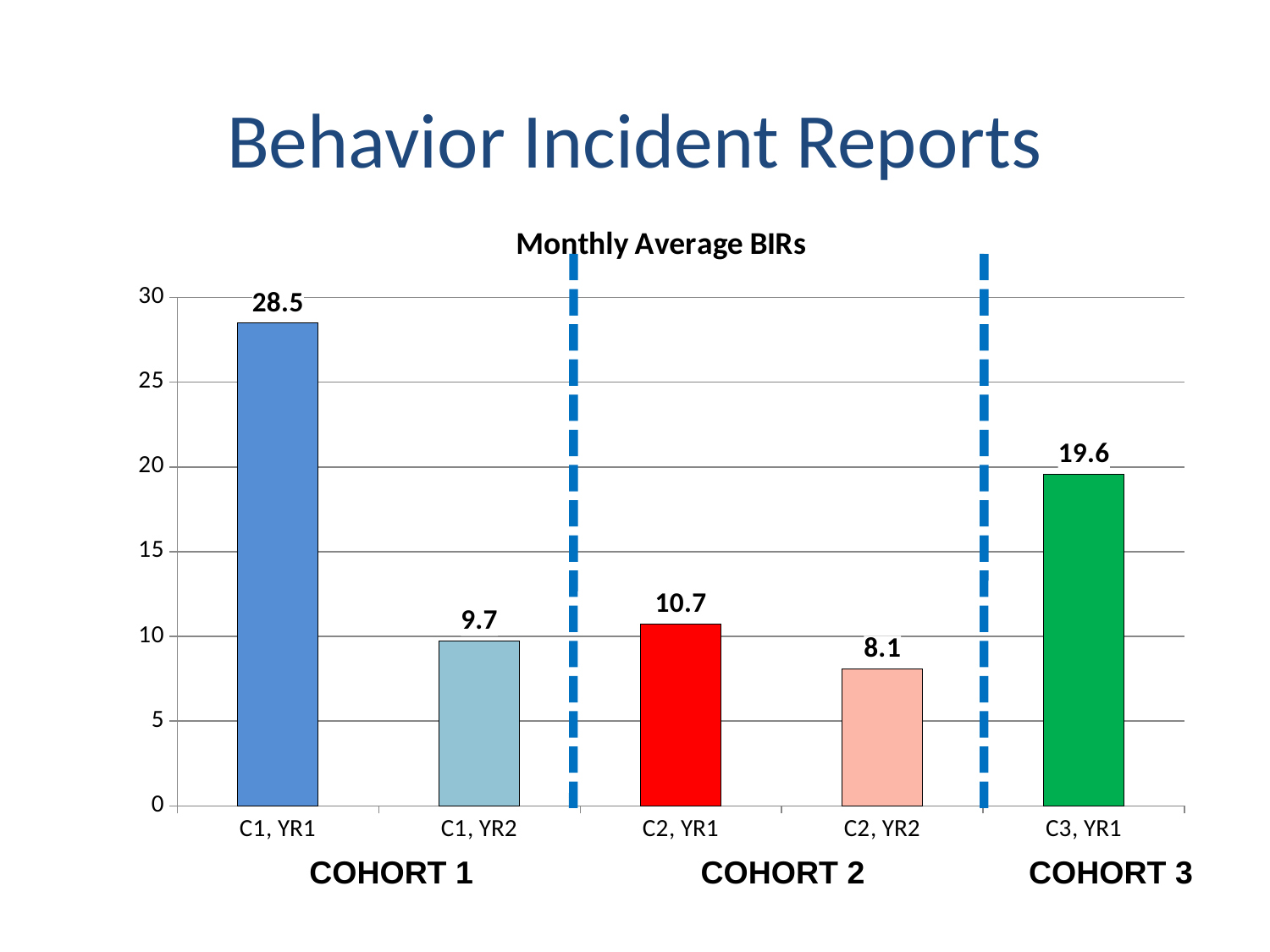
Which is larger, the value for C3, YR1 or the value for C2, YR1? C3, YR1 What is the monthly average BIRs value for C2, YR2? 8.1 What is the monthly average BIRs value for C3, YR1? 19.6 What kind of chart is shown on the slide? bar chart Which category has the highest monthly average BIRs? C1, YR1 How many bars are plotted in the chart? 5 What is the title of the chart? Monthly Average BIRs Which category has the lowest monthly average BIRs? C2, YR2 What is the difference between the C1, YR1 and C1, YR2 values? 18.8 What is the difference between the C2, YR1 and C2, YR2 values? 2.6 What is the monthly average BIRs value for C1, YR1? 28.5 Is the value for C1, YR2 greater or less than 10? less